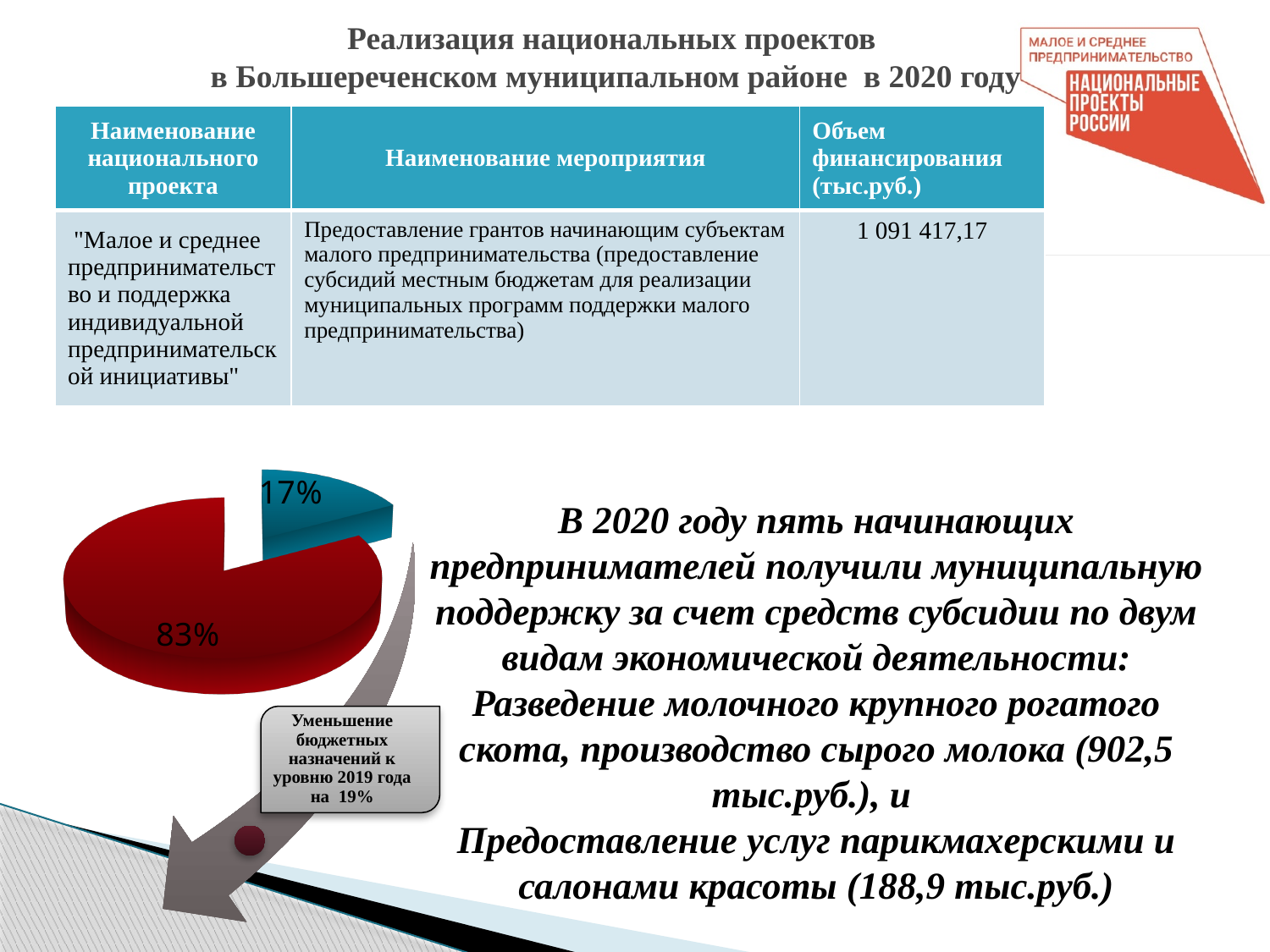
What is the largest value shown on the pie chart? 83% By how many percentage points does the red slice exceed the teal slice? 66 What colour is the slice labelled 17%? teal Is the value of the teal slice greater or less than 20%? less Which slice of the pie chart is larger, the red one or the teal one? the red one What kind of chart is shown on the slide? pie chart What is the smallest value shown on the pie chart? 17% Do the two slice values on the pie chart add up to 100%? yes What share of the pie does the red slice represent? 83% Is the value of the red slice greater or less than 80%? greater How many slices does the pie chart have? 2 What share of the pie does the teal slice represent? 17%